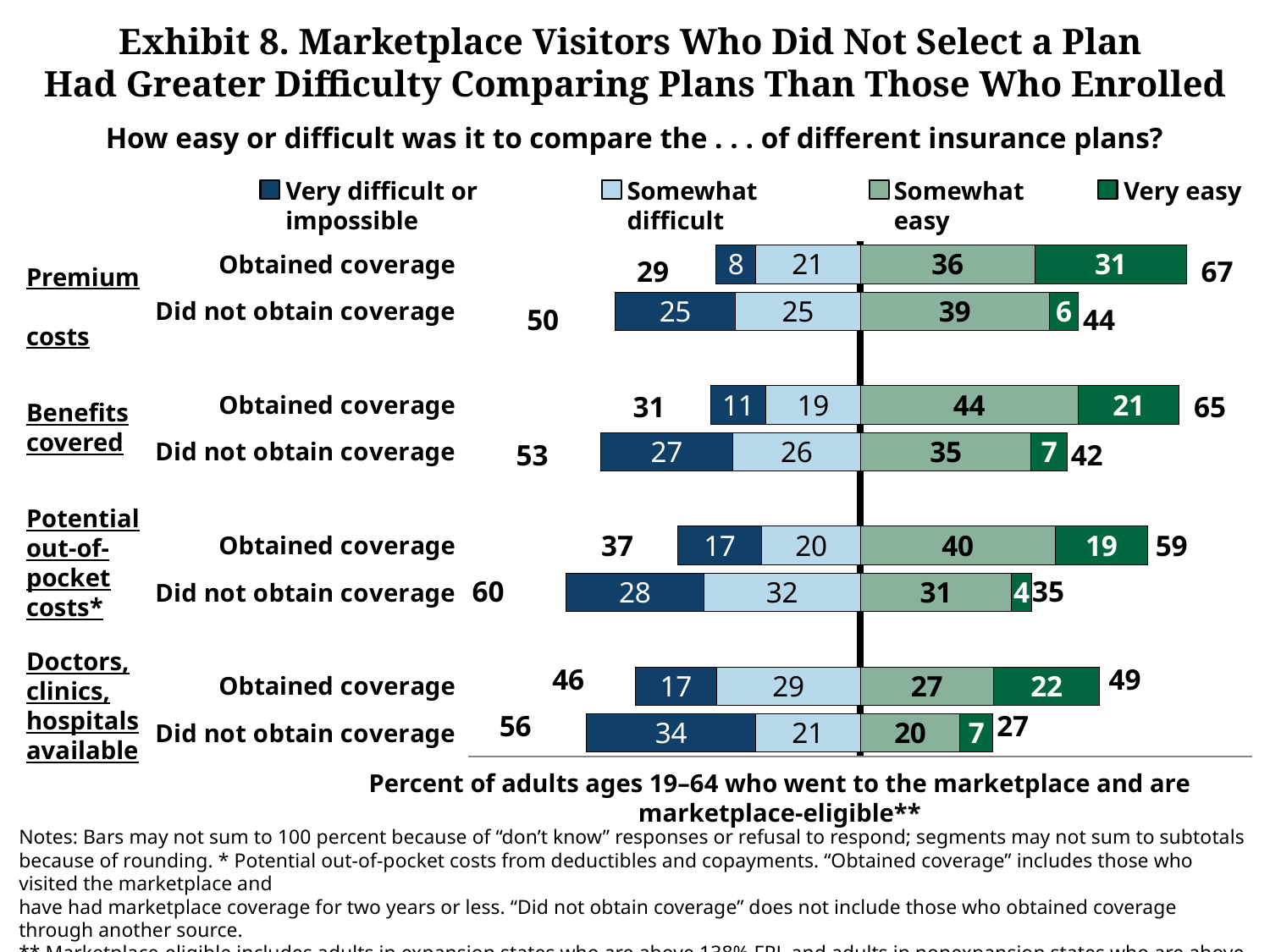
Which legend entry is shown in the darkest blue colour? Very difficult or impossible What percentage of adults who did not obtain coverage said comparing benefits covered was very difficult or impossible? 27 What is the combined 'difficult' subtotal for adults who did not obtain coverage when comparing doctors, clinics, hospitals available? 56 Among the 'Did not obtain coverage' rows, which plan feature has the lowest 'easy' subtotal? Doctors, clinics, hospitals available For premium costs, how much larger is the 'easy' subtotal for those who obtained coverage than for those who did not obtain coverage? 23 What percentage of adults who obtained coverage said comparing premium costs was very easy? 31 For doctors, clinics, hospitals available, which group has the larger 'very difficult or impossible' share: obtained coverage or did not obtain coverage? Did not obtain coverage What is the combined 'easy' subtotal for adults who obtained coverage when comparing benefits covered? 65 How many series does the legend list? 4 What kind of chart is shown on the slide? Stacked bar chart Among the 'Obtained coverage' rows, which plan feature has the highest 'easy' subtotal? Premium costs What percentage of adults who did not obtain coverage said comparing potential out-of-pocket costs was somewhat difficult? 32